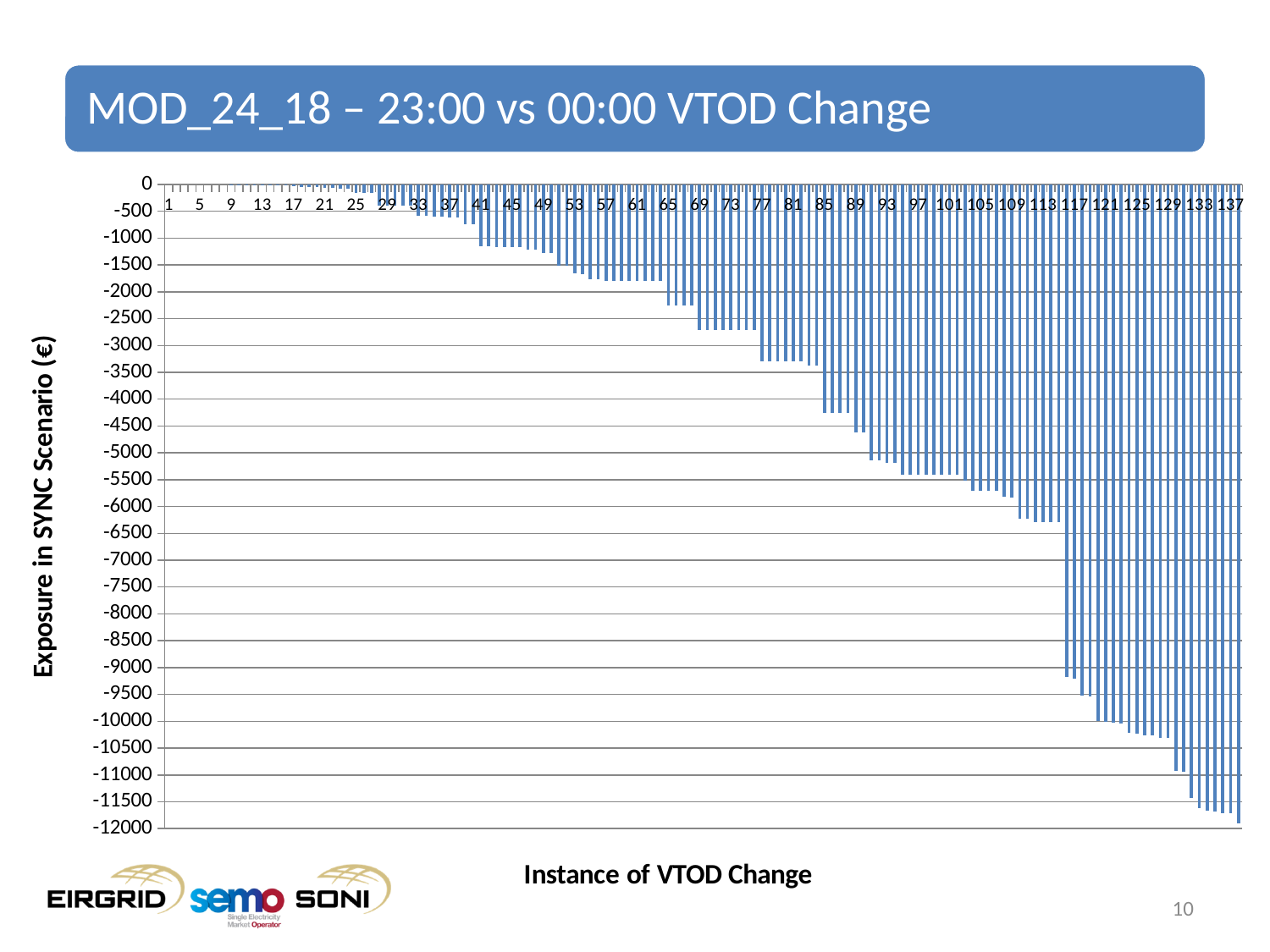
Is the value for instance 85 greater or less than -3500? less Do the values rise or fall as the instance number increases along the x axis? fall Is the value for instance 77 greater or less than -3000? less What is the title of the y axis? Exposure in SYNC Scenario (€) Is the value for instance 65 greater or less than -2500? greater What is the title of the x axis? Instance of VTOD Change What kind of chart is shown on the slide? bar chart